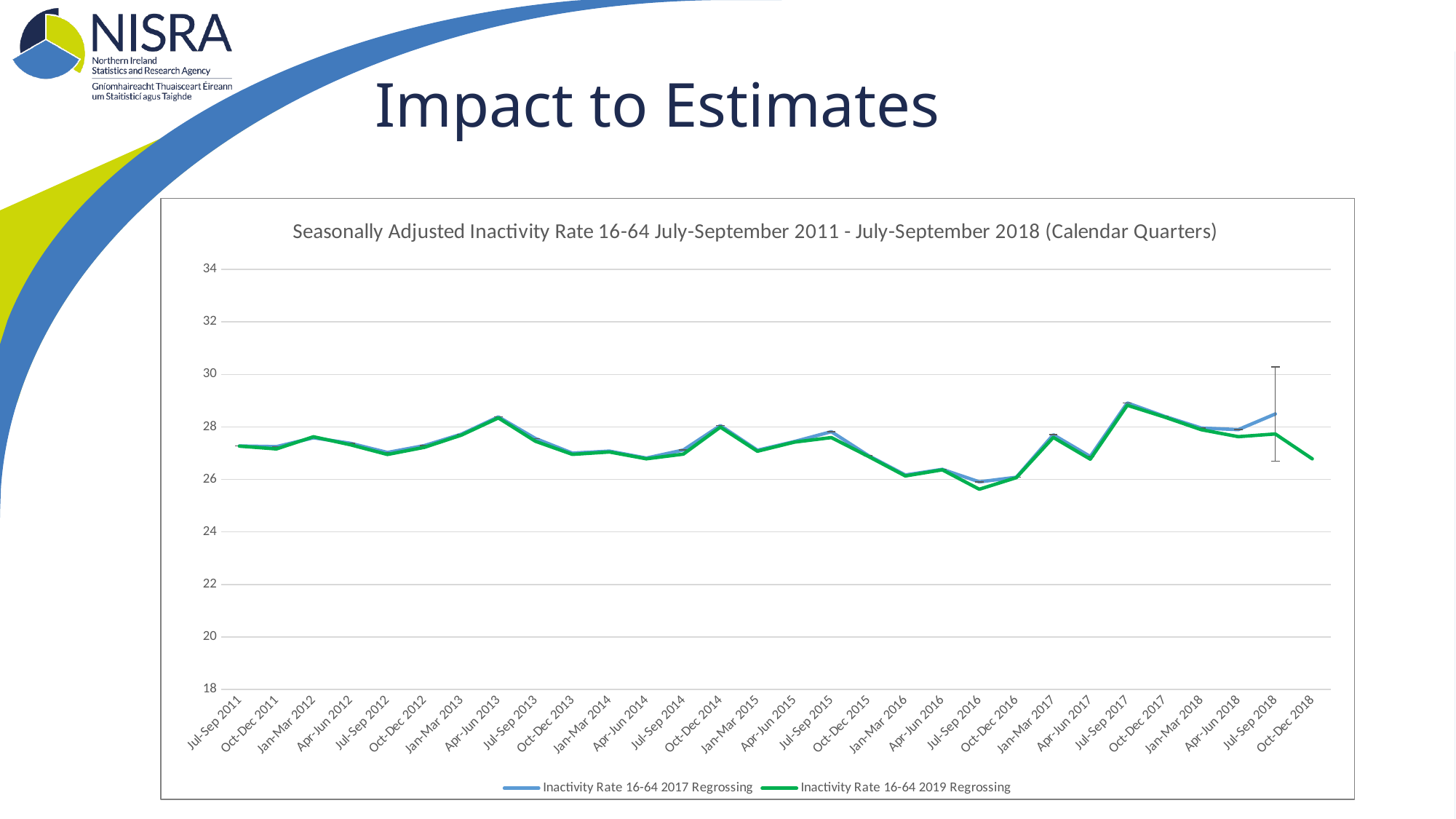
What kind of chart is shown on the slide? Line chart Is the value for Jul-Sep 2016 in the 2019 Regrossing series greater or less than 26? less Which series is drawn in green? Inactivity Rate 16-64 2019 Regrossing In which quarter does the Inactivity Rate 16-64 2019 Regrossing series reach its lowest value? Jul-Sep 2016 How many series does the legend list? 2 Is the value for Jul-Sep 2017 in the 2019 Regrossing series greater or less than 28? greater Does the 2019 Regrossing series rise or fall between Jul-Sep 2017 and Oct-Dec 2018? Fall Is the value for Jan-Mar 2016 in the 2017 Regrossing series greater or less than 28? less How many quarters are plotted along the x axis? 30 In which quarter does the Inactivity Rate 16-64 2019 Regrossing series reach its highest value? Jul-Sep 2017 What is the title of the chart? Seasonally Adjusted Inactivity Rate 16-64 July-September 2011 - July-September 2018 (Calendar Quarters) For Jul-Sep 2018, which series shows the higher value, 2017 Regrossing or 2019 Regrossing? 2017 Regrossing